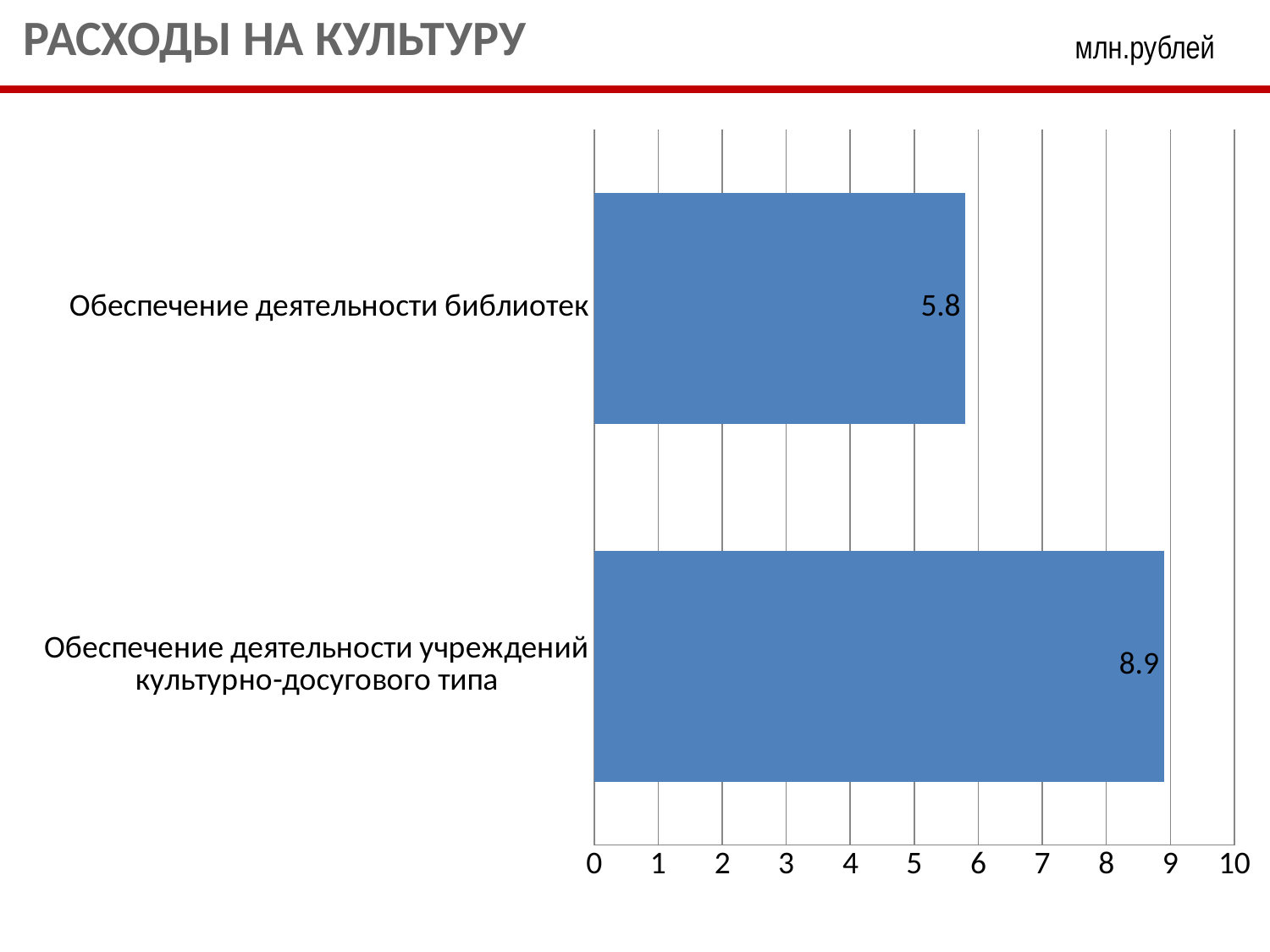
How many categories are shown in the chart? 2 What kind of chart is shown on the slide? bar chart What is the value for Обеспечение деятельности учреждений культурно-досугового типа? 8.9 What is the title of the slide? РАСХОДЫ НА КУЛЬТУРУ What is the difference between the values for Обеспечение деятельности учреждений культурно-досугового типа and Обеспечение деятельности библиотек? 3.1 What unit is indicated for the values on the slide? млн.рублей Which is larger: the value for Обеспечение деятельности библиотек or the value for Обеспечение деятельности учреждений культурно-досугового типа? Обеспечение деятельности учреждений культурно-досугового типа What is the value for Обеспечение деятельности библиотек? 5.8 Is the value for Обеспечение деятельности учреждений культурно-досугового типа greater or less than 9? less Which category has the lowest value? Обеспечение деятельности библиотек Is the value for Обеспечение деятельности библиотек greater or less than 5? greater Which category has the highest value? Обеспечение деятельности учреждений культурно-досугового типа